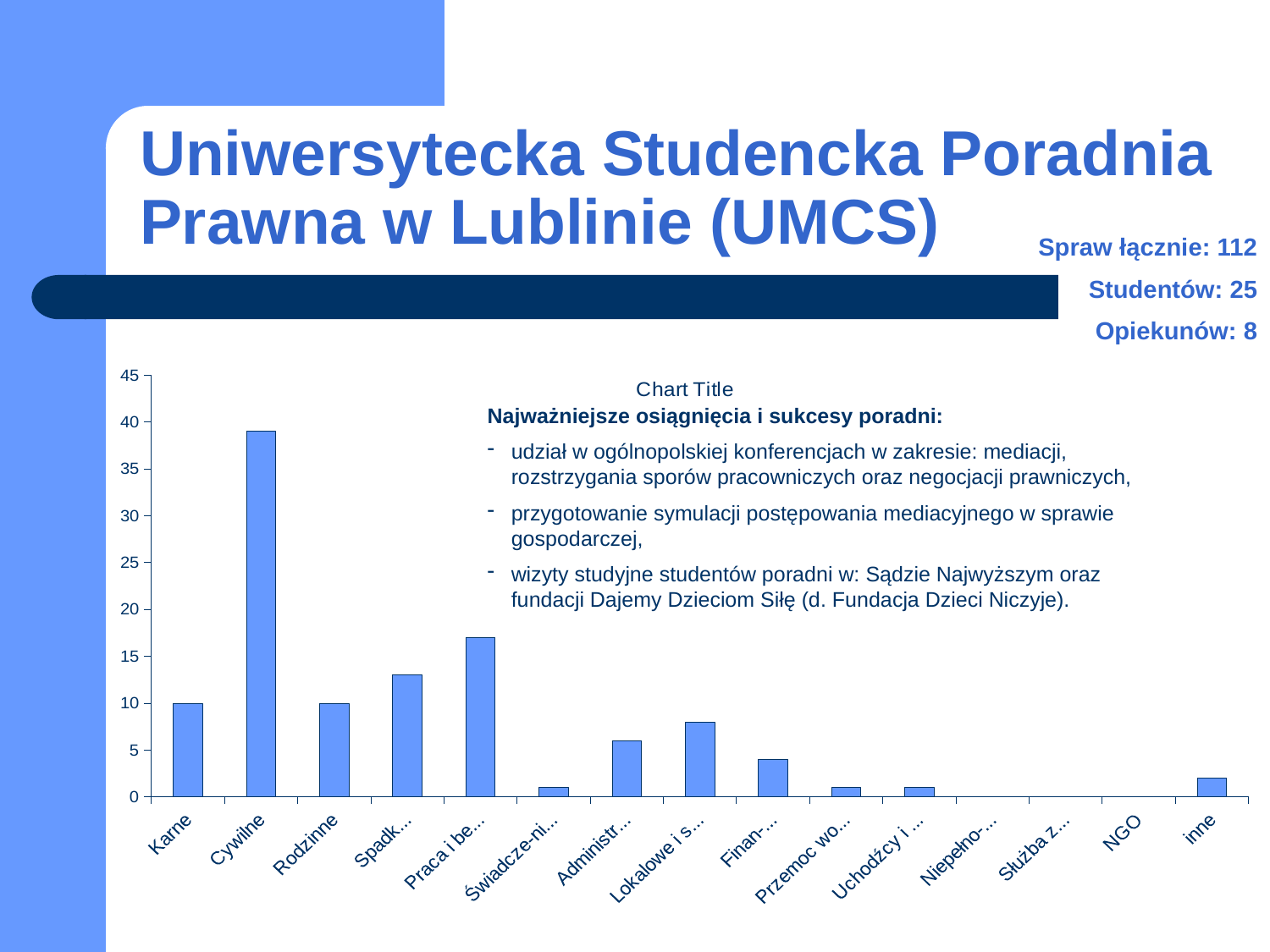
What kind of chart is shown on the slide? bar chart What is the value for Karne? 10 Which category has the highest value in the chart? Cywilne What is the title shown on the chart? Chart Title Is the value for Administr... greater or less than 10? less Which is larger, the value for Cywilne or the value for Karne? Cywilne How many categories are shown on the x axis of the chart? 15 Is the value for inne greater or less than 5? less Is the value for Cywilne greater or less than 35? greater What is the value for Rodzinne? 10 Which is larger, the value for Karne or the value for inne? Karne